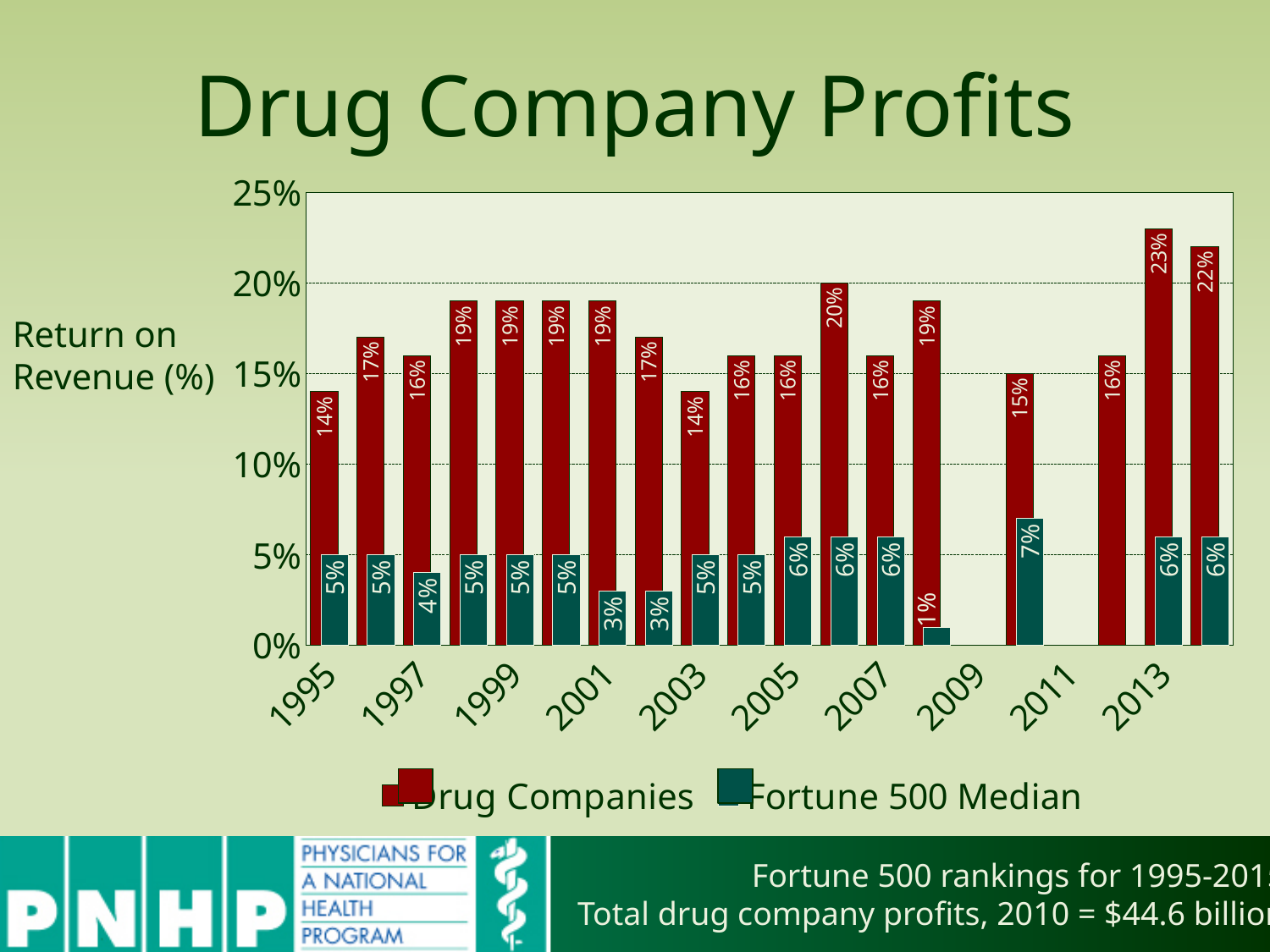
What is the label on the vertical axis of the chart? Return on Revenue (%) What is the Fortune 500 Median value for 1997? 4% What type of chart is shown on the slide? Bar chart How many series does the legend list? 2 What is the Fortune 500 Median value for 2001? 3% What is the Drug Companies value for 2007? 16% Which year has the higher Drug Companies value, 2001 or 2003? 2001 What is the lowest Fortune 500 Median value shown in the chart? 1% In 2013, how much higher is the Drug Companies value than the Fortune 500 Median? 17 percentage points What is the Drug Companies return on revenue for 1995? 14% What is the Drug Companies value for 2013? 23% What is the highest Drug Companies value shown in the chart? 23%